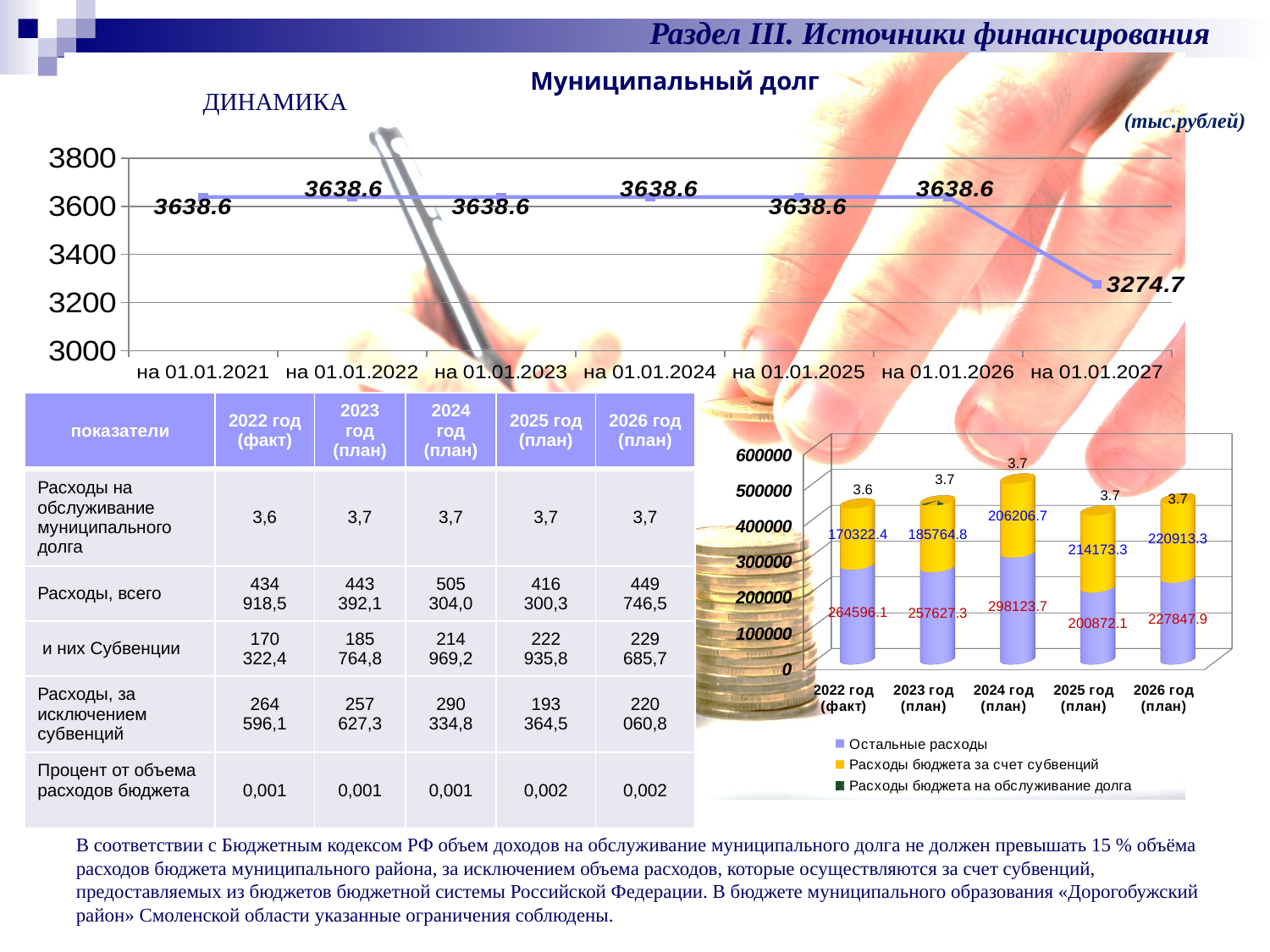
On the stacked bar chart at the bottom right, which is larger for 2025 год (план): 'Остальные расходы' or 'Расходы бюджета за счет субвенций'? Расходы бюджета за счет субвенций On the line chart 'Муниципальный долг', what is the difference between the value for на 01.01.2026 and the value for на 01.01.2027? 363.9 On the line chart 'Муниципальный долг', what is the value for на 01.01.2027? 3274.7 What kind of chart is the chart at the bottom right of the slide? stacked bar chart On the stacked bar chart at the bottom right, what is the value of 'Расходы бюджета за счет субвенций' for 2026 год (план)? 220913.3 On the line chart 'Муниципальный долг', does the value rise, fall or stay flat between на 01.01.2026 and на 01.01.2027? fall On the stacked bar chart at the bottom right, what is the value of 'Остальные расходы' for 2024 год (план)? 298123.7 On the stacked bar chart at the bottom right, how many series does the legend list? 3 On the line chart 'Муниципальный долг', what is the value for на 01.01.2021? 3638.6 On the line chart 'Муниципальный долг', how many data points are plotted? 7 On the stacked bar chart at the bottom right, what is the value of 'Расходы бюджета на обслуживание долга' for 2022 год (факт)? 3.6 On the line chart 'Муниципальный долг', which date has the lowest value? на 01.01.2027